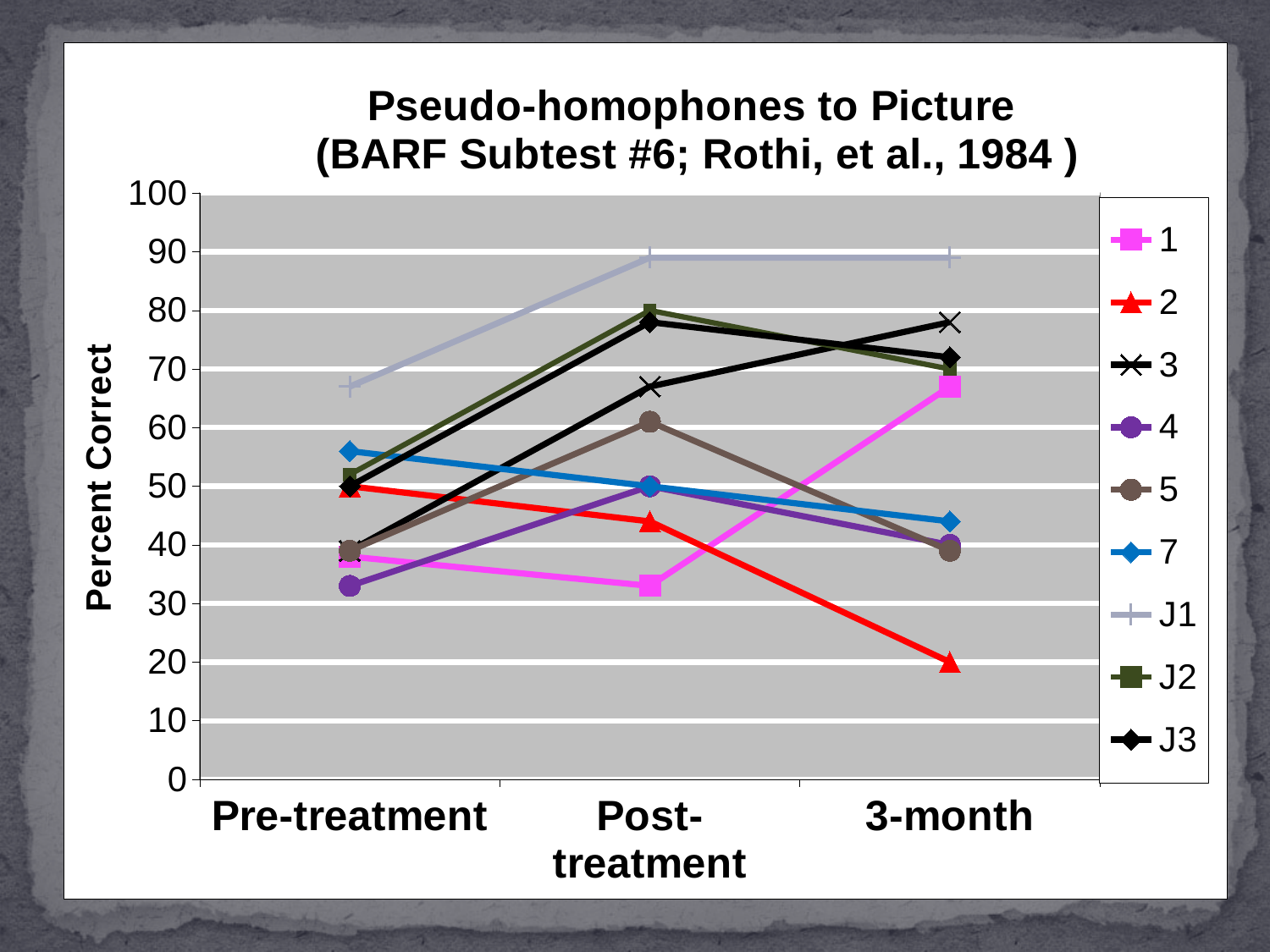
How many series does the legend list? 9 What kind of chart is shown on the slide? line chart Which series has the highest value at 3-month? J1 Which series has the highest value at Pre-treatment? J1 Which series has the lowest value at 3-month? 2 What is the value for series 2 at 3-month? 20 What is the value for series J2 at Post-treatment? 80 How many time points are shown on the x axis? 3 Does the value for series 2 rise or fall from Pre-treatment to 3-month? fall What is the y-axis title of the chart? Percent Correct Is the value for series J1 at Post-treatment greater or less than 80? greater